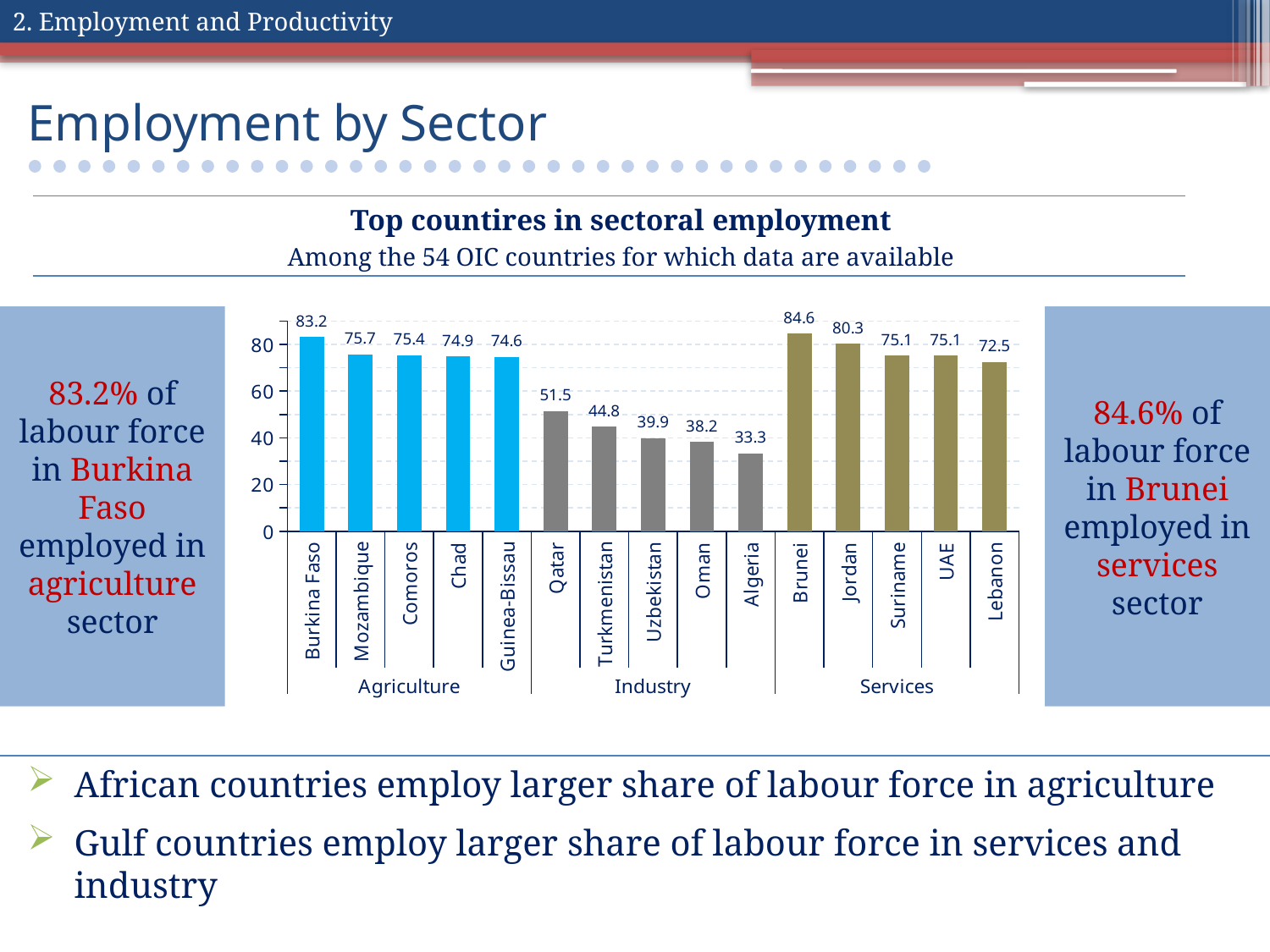
Which is larger, the value for Jordan or the value for Mozambique? Jordan What is the difference between the values for Qatar and Algeria? 18.2 Which country has the lowest value on the chart? Algeria Which country has the highest value on the chart? Brunei Is the value for Oman greater or less than 40? less What is the value for Qatar in the Industry group? 51.5 What is the value for Burkina Faso in the Agriculture group? 83.2 How many countries are shown on the chart? 15 What is the title of the chart? Top countires in sectoral employment What is the difference between the values for Brunei and Burkina Faso? 1.4 What is the value for Lebanon in the Services group? 72.5 What kind of chart is shown on the slide? Bar chart